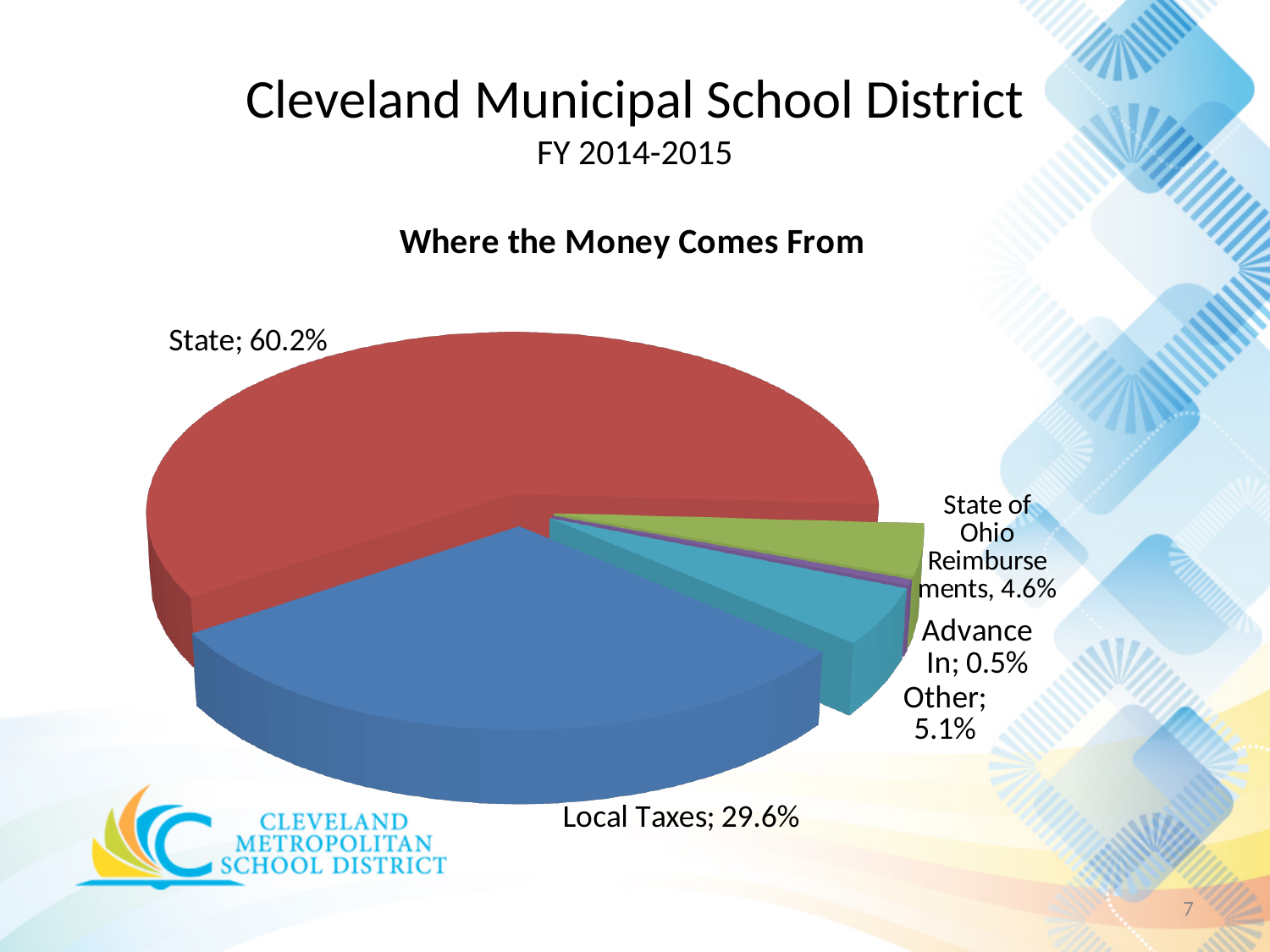
What share of the money comes from State of Ohio Reimbursements? 4.6% What is the chart's title? Where the Money Comes From What share of the money comes from Local Taxes? 29.6% What kind of chart is shown on the slide? Pie chart Which is larger, the share for Other or the share for State of Ohio Reimbursements? Other Which source provides the smallest share of the money? Advance In How many slices does the pie chart have? 5 What is the difference in percentage points between the State share and the Local Taxes share? 30.6 What share of the money comes from State? 60.2% Which source provides the largest share of the money? State What share of the money comes from Other? 5.1% What share of the money comes from Advance In? 0.5%